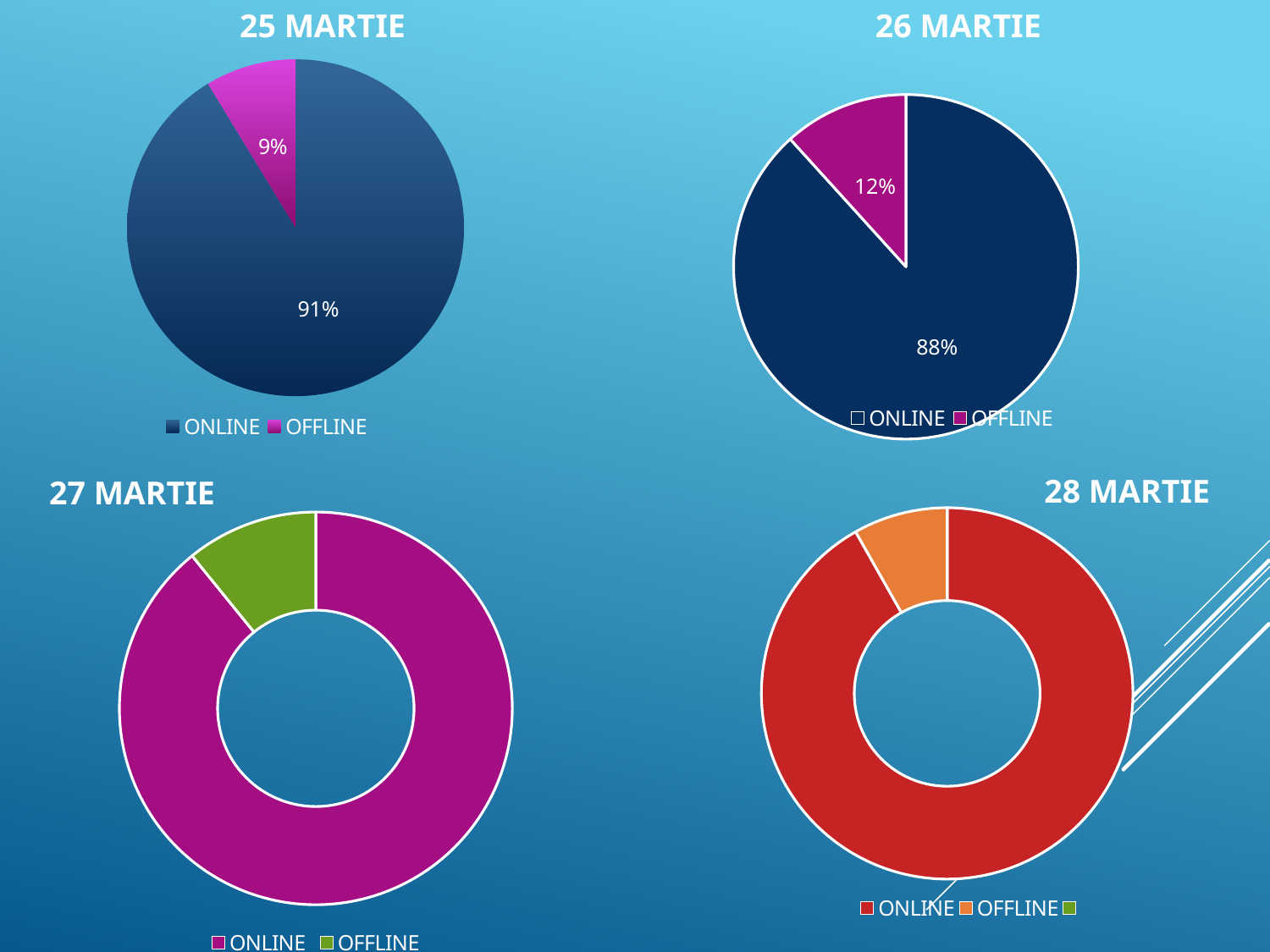
In the 25 MARTIE chart, what percentage is OFFLINE? 9% In the 27 MARTIE chart, which category has the larger share? ONLINE In the 26 MARTIE chart, which category has the smallest share? OFFLINE Is the OFFLINE share larger in the 25 MARTIE chart or the 26 MARTIE chart? 26 MARTIE In the 25 MARTIE chart, what percentage is ONLINE? 91% In the 25 MARTIE chart, which category has the largest share? ONLINE In the 28 MARTIE chart, which category has the smaller visible share? OFFLINE In the 26 MARTIE chart, what percentage is OFFLINE? 12% In the 26 MARTIE chart, what percentage is ONLINE? 88% In the 25 MARTIE chart, what is the difference between the ONLINE and OFFLINE shares? 82% How many charts are shown on the slide? 4 What kind of chart is the 27 MARTIE chart? Doughnut chart